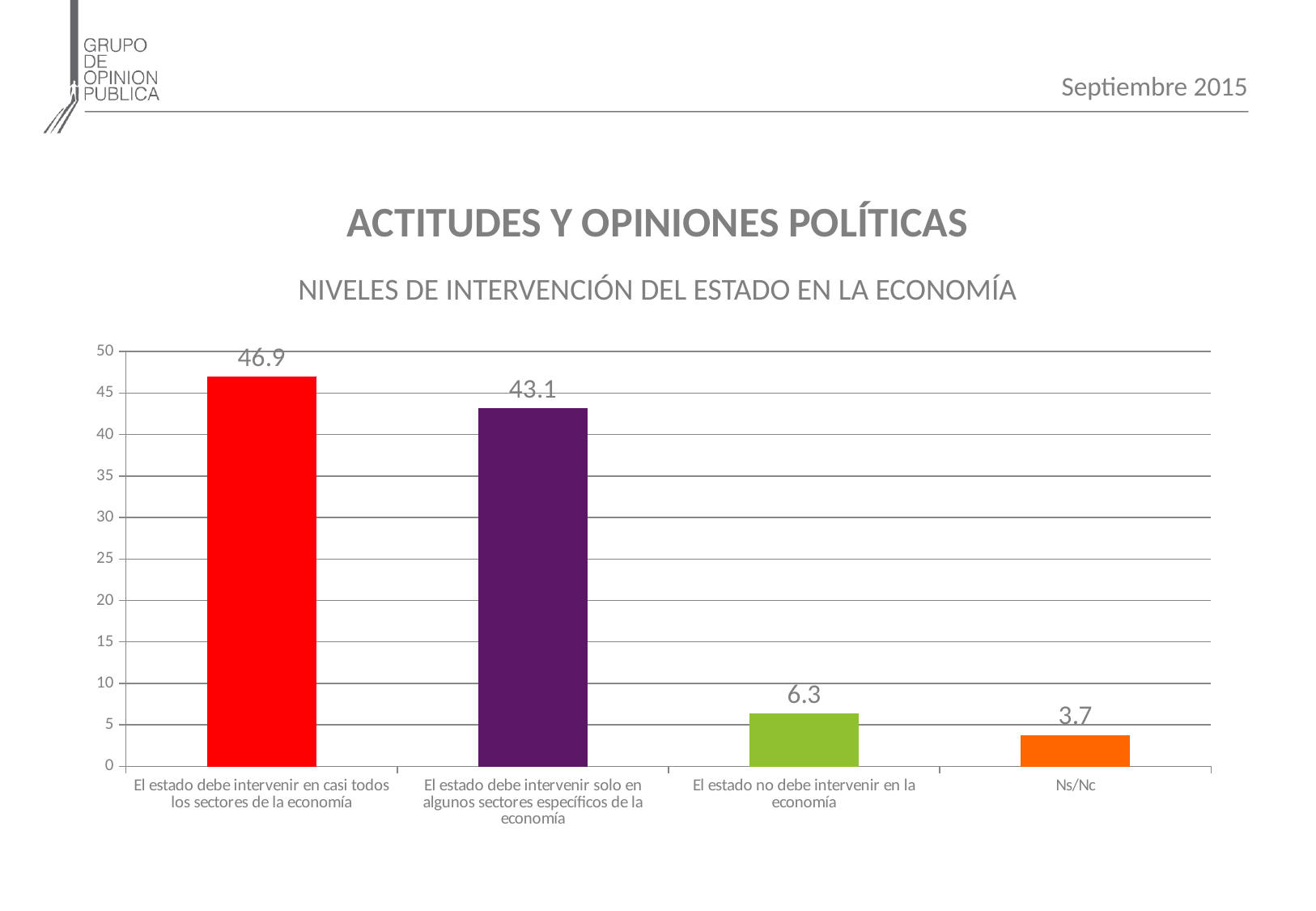
What kind of chart is shown on the slide? Bar chart What is the value for 'El estado debe intervenir solo en algunos sectores específicos de la economía'? 43.1 What is the value for 'El estado debe intervenir en casi todos los sectores de la economía'? 46.9 What is the difference between the values for 'El estado debe intervenir en casi todos los sectores de la economía' and 'El estado debe intervenir solo en algunos sectores específicos de la economía'? 3.8 What is the difference between the values for 'El estado no debe intervenir en la economía' and 'Ns/Nc'? 2.6 What is the subtitle of the chart? NIVELES DE INTERVENCIÓN DEL ESTADO EN LA ECONOMÍA Which is larger, the value for 'El estado no debe intervenir en la economía' or the value for 'Ns/Nc'? El estado no debe intervenir en la economía What is the value for 'Ns/Nc'? 3.7 Which category has the lowest value? Ns/Nc What is the value for 'El estado no debe intervenir en la economía'? 6.3 How many categories are shown in the chart? 4 Which category has the highest value? El estado debe intervenir en casi todos los sectores de la economía